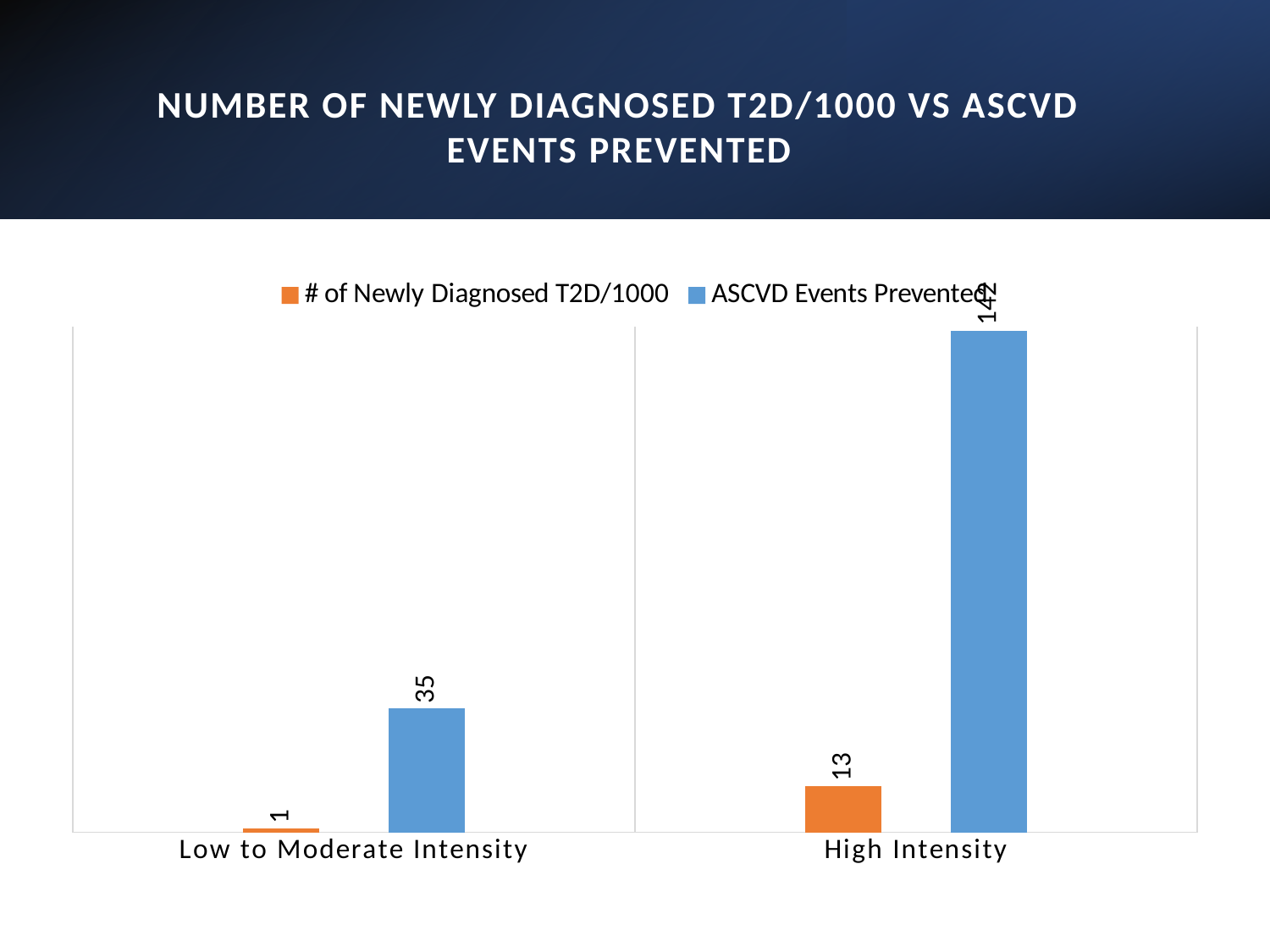
What is the value of # of Newly Diagnosed T2D/1000 for Low to Moderate Intensity? 1 What is the value of ASCVD Events Prevented for Low to Moderate Intensity? 35 What is the value of # of Newly Diagnosed T2D/1000 for High Intensity? 13 How many series does the legend list? 2 Which category has the higher value for ASCVD Events Prevented? High Intensity What is the value of ASCVD Events Prevented for High Intensity? 142 Which category has the lower value for # of Newly Diagnosed T2D/1000? Low to Moderate Intensity What is the difference between ASCVD Events Prevented and # of Newly Diagnosed T2D/1000 for Low to Moderate Intensity? 34 How many categories are shown on the x axis? 2 Is the value of ASCVD Events Prevented larger for High Intensity or for Low to Moderate Intensity? High Intensity What kind of chart is shown on the slide? Bar chart What is the difference in # of Newly Diagnosed T2D/1000 between High Intensity and Low to Moderate Intensity? 12